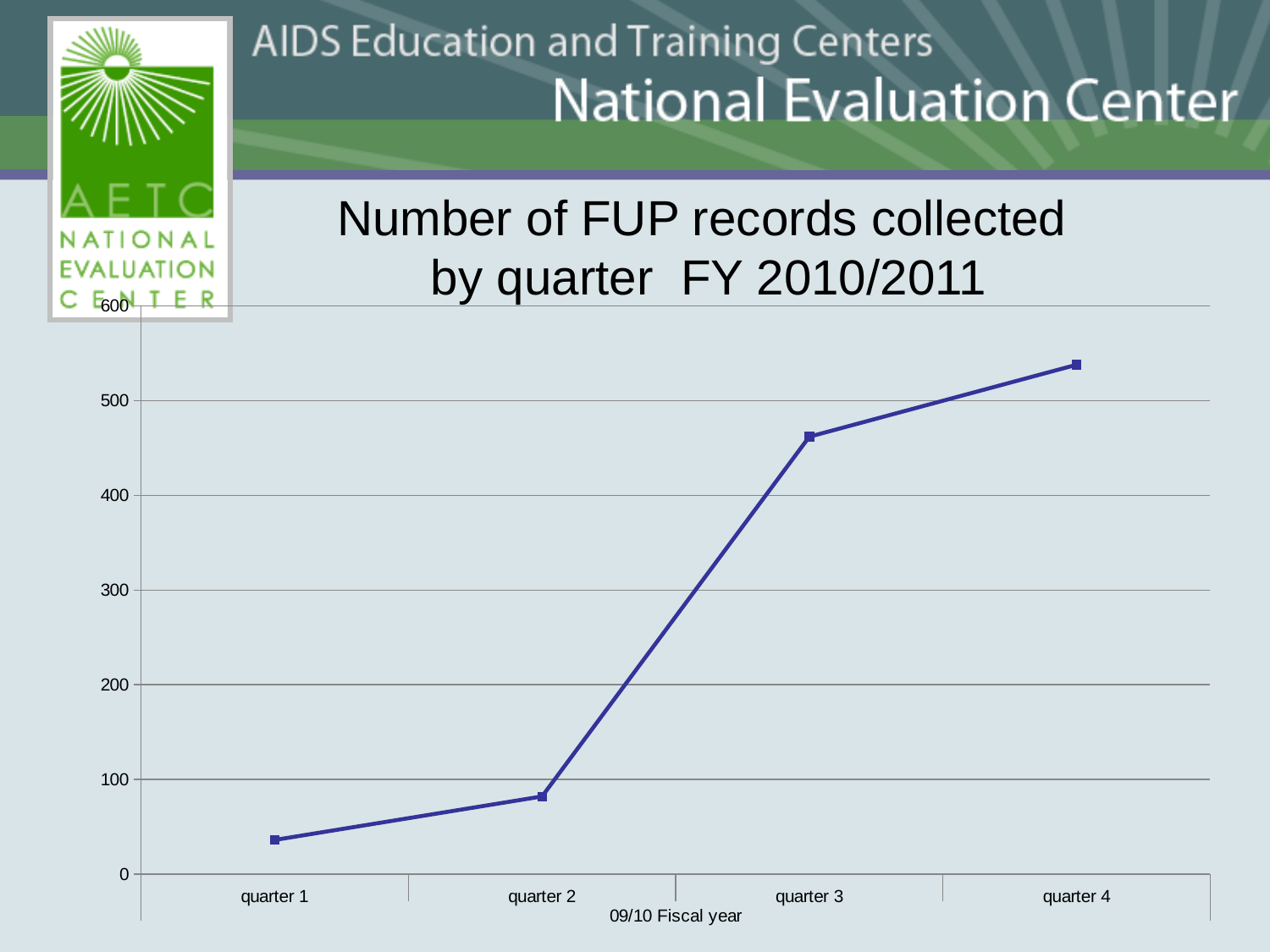
What is the title of the chart? Number of FUP records collected by quarter FY 2010/2011 What kind of chart is shown on the slide? line chart Which quarter has the highest number of FUP records collected? quarter 4 What is the label on the x axis of the chart? 09/10 Fiscal year Is the value for quarter 2 greater or less than 100? less How many quarters are plotted on the chart? 4 Is the value for quarter 1 greater or less than 100? less Is the value for quarter 4 greater or less than 500? greater Which quarter has the lowest number of FUP records collected? quarter 1 Which is larger, the value for quarter 2 or the value for quarter 3? quarter 3 Do the values rise or fall from quarter 1 to quarter 4? rise